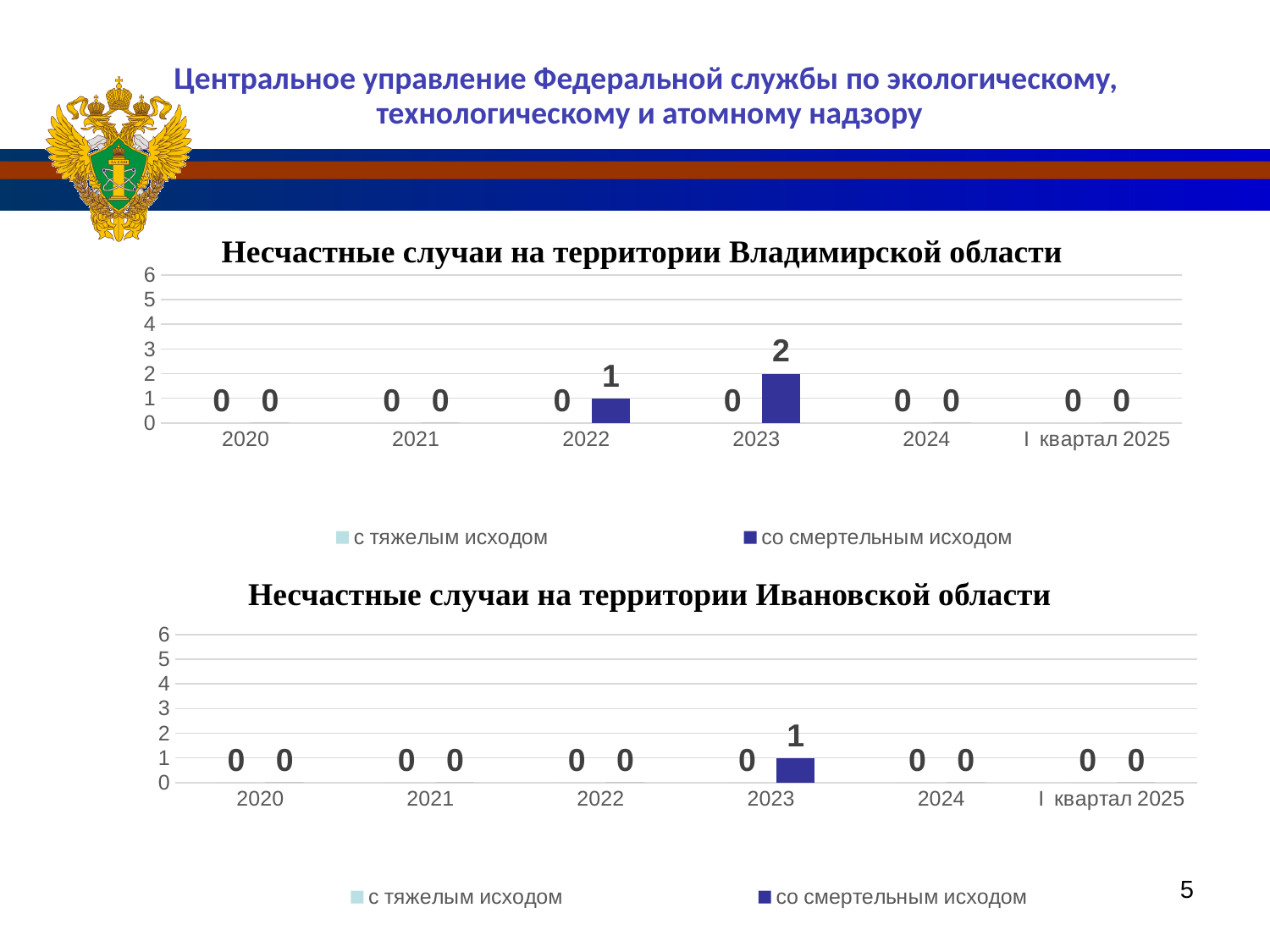
In the chart 'Несчастные случаи на территории Ивановской области', what is the value for 'со смертельным исходом' in 2024? 0 In the chart 'Несчастные случаи на территории Владимирской области', how many categories are shown on the x axis? 6 In the chart 'Несчастные случаи на территории Владимирской области', what is the value for 'со смертельным исходом' in 2022? 1 In the chart 'Несчастные случаи на территории Ивановской области', which year has the highest value for 'со смертельным исходом'? 2023 In the chart 'Несчастные случаи на территории Владимирской области', what is the value for 'со смертельным исходом' in 2023? 2 Which is larger: the 'со смертельным исходом' value for 2023 in the Владимирской области chart or in the Ивановской области chart? Владимирской области What type of chart is 'Несчастные случаи на территории Ивановской области'? Bar chart In the chart 'Несчастные случаи на территории Владимирской области', what is the difference between the 'со смертельным исходом' values for 2023 and 2022? 1 In the chart 'Несчастные случаи на территории Владимирской области', which year has the highest value for 'со смертельным исходом'? 2023 In the chart 'Несчастные случаи на территории Ивановской области', what is the value for 'со смертельным исходом' in 2023? 1 In the chart 'Несчастные случаи на территории Владимирской области', what is the value for 'с тяжелым исходом' in 2023? 0 In the chart 'Несчастные случаи на территории Владимирской области', how many series does the legend list? 2